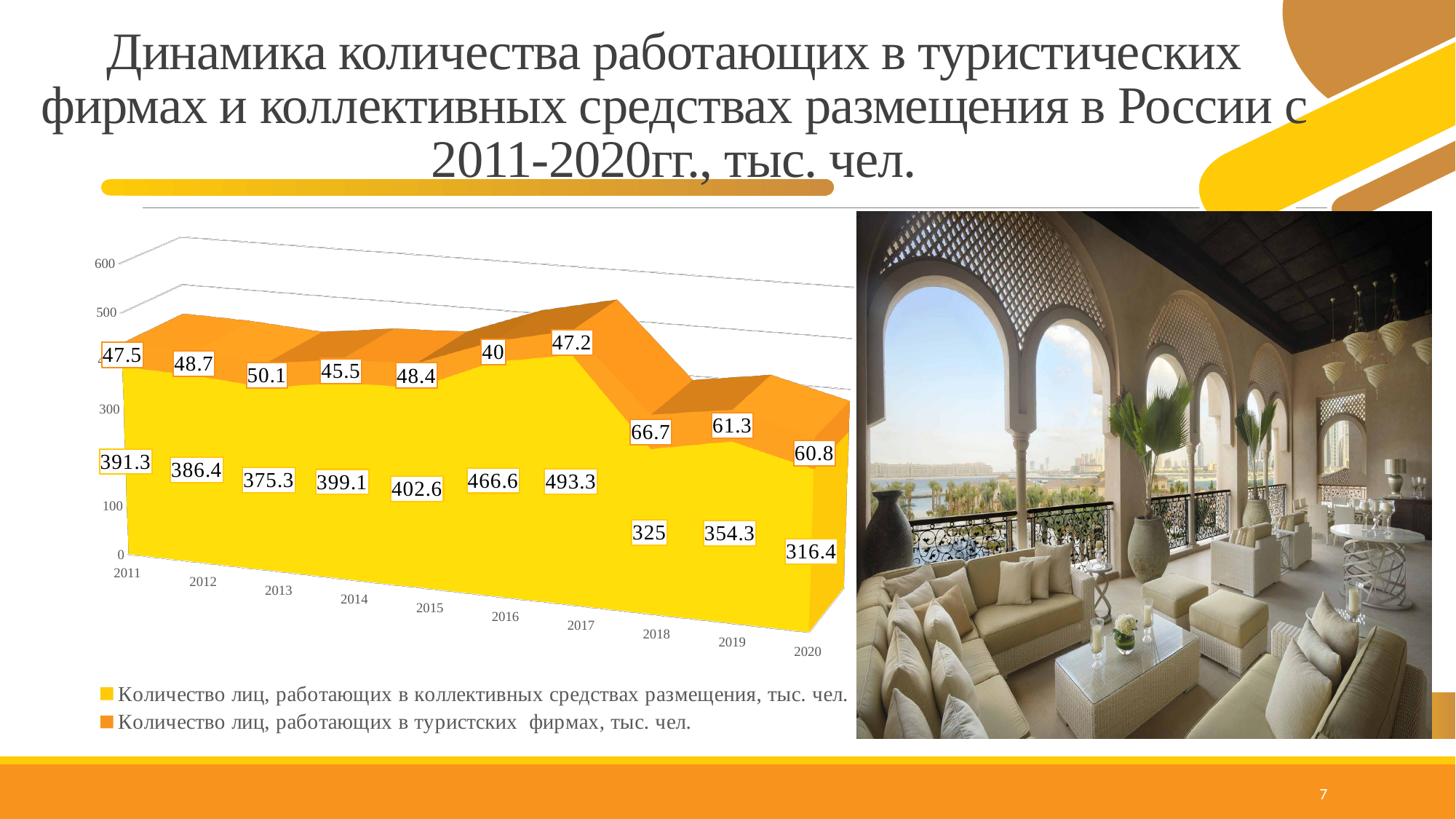
How many years are shown on the x axis? 10 What kind of chart is shown on the slide? Area chart What is the total of the two series for 2020? 377.2 In which year is the value for 'Количество лиц, работающих в туристских фирмах, тыс. чел.' lowest? 2016 How many series does the legend list? 2 What is the value for 2018 in the series 'Количество лиц, работающих в туристских фирмах, тыс. чел.'? 66.7 What is the value for 2020 in the series 'Количество лиц, работающих в коллективных средствах размещения, тыс. чел.'? 316.4 What is the value for 2017 in the series 'Количество лиц, работающих в коллективных средствах размещения, тыс. чел.'? 493.3 In which year is the value for 'Количество лиц, работающих в туристских фирмах, тыс. чел.' highest? 2018 What is the difference between the 2017 and 2018 values for 'Количество лиц, работающих в коллективных средствах размещения, тыс. чел.'? 168.3 In which year is the value for 'Количество лиц, работающих в коллективных средствах размещения, тыс. чел.' highest? 2017 Which year has the larger value for 'Количество лиц, работающих в коллективных средствах размещения, тыс. чел.': 2016 or 2019? 2016